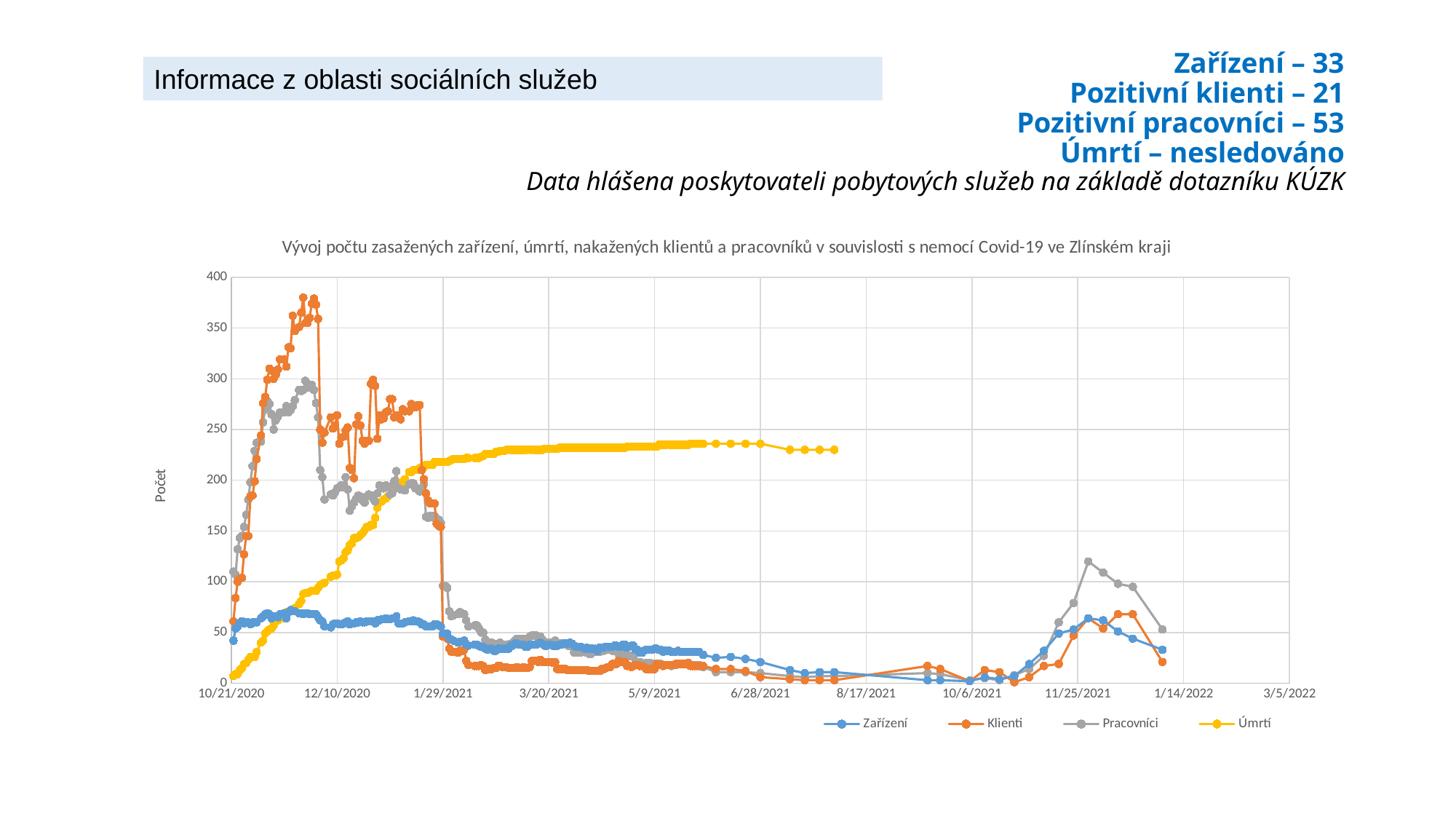
Which series reaches the highest value anywhere on the chart? Klienti Is the highest value of the Pracovníci series greater or less than 250? greater How many series does the chart legend list? 4 What kind of chart is shown on the slide? line chart What is the label of the vertical axis of the chart? Počet Does the Úmrtí series rise or fall along the x axis over the period it is plotted? rise Around the peak near 11/25/2021, which series is higher: Pracovníci or Klienti? Pracovníci What are the series names listed in the chart legend? Zařízení, Klienti, Pracovníci, Úmrtí Is the peak value of the Zařízení series greater or less than 100? less Is the peak value of the Klienti series greater or less than 350? greater Which series has the lowest value at the start of the chart (10/21/2020)? Úmrtí